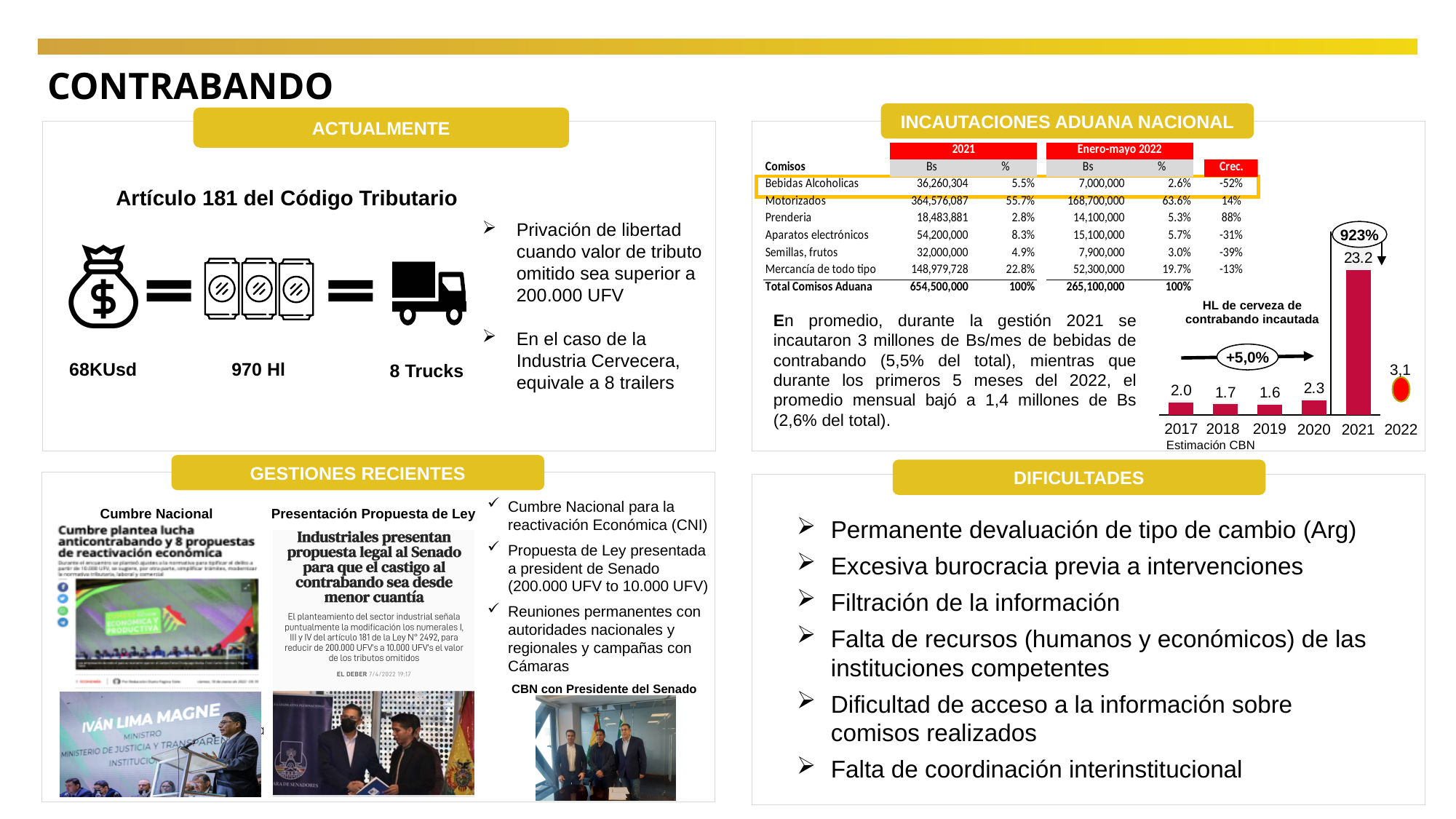
In the chart 'HL de cerveza de contrabando incautada', what is the value for 2017? 2.0 In the chart 'HL de cerveza de contrabando incautada', what percentage growth is annotated above the 2021 bar? 923% How many years are shown on the x axis of the chart 'HL de cerveza de contrabando incautada'? 6 What kind of chart is 'HL de cerveza de contrabando incautada'? bar chart In the chart 'HL de cerveza de contrabando incautada', what is the difference between the values for 2021 and 2020? 20.9 In the chart 'HL de cerveza de contrabando incautada', what is the value for 2021? 23.2 In the chart 'HL de cerveza de contrabando incautada', which is larger, the value for 2018 or the value for 2020? 2020 In the chart 'HL de cerveza de contrabando incautada', what is the value for 2020? 2.3 In the chart 'HL de cerveza de contrabando incautada', which year has the lowest value? 2019 In the chart 'HL de cerveza de contrabando incautada', what is the value shown for 2022? 3,1 In the chart 'HL de cerveza de contrabando incautada', which year has the highest value? 2021 What is the title of the chart on the slide? HL de cerveza de contrabando incautada